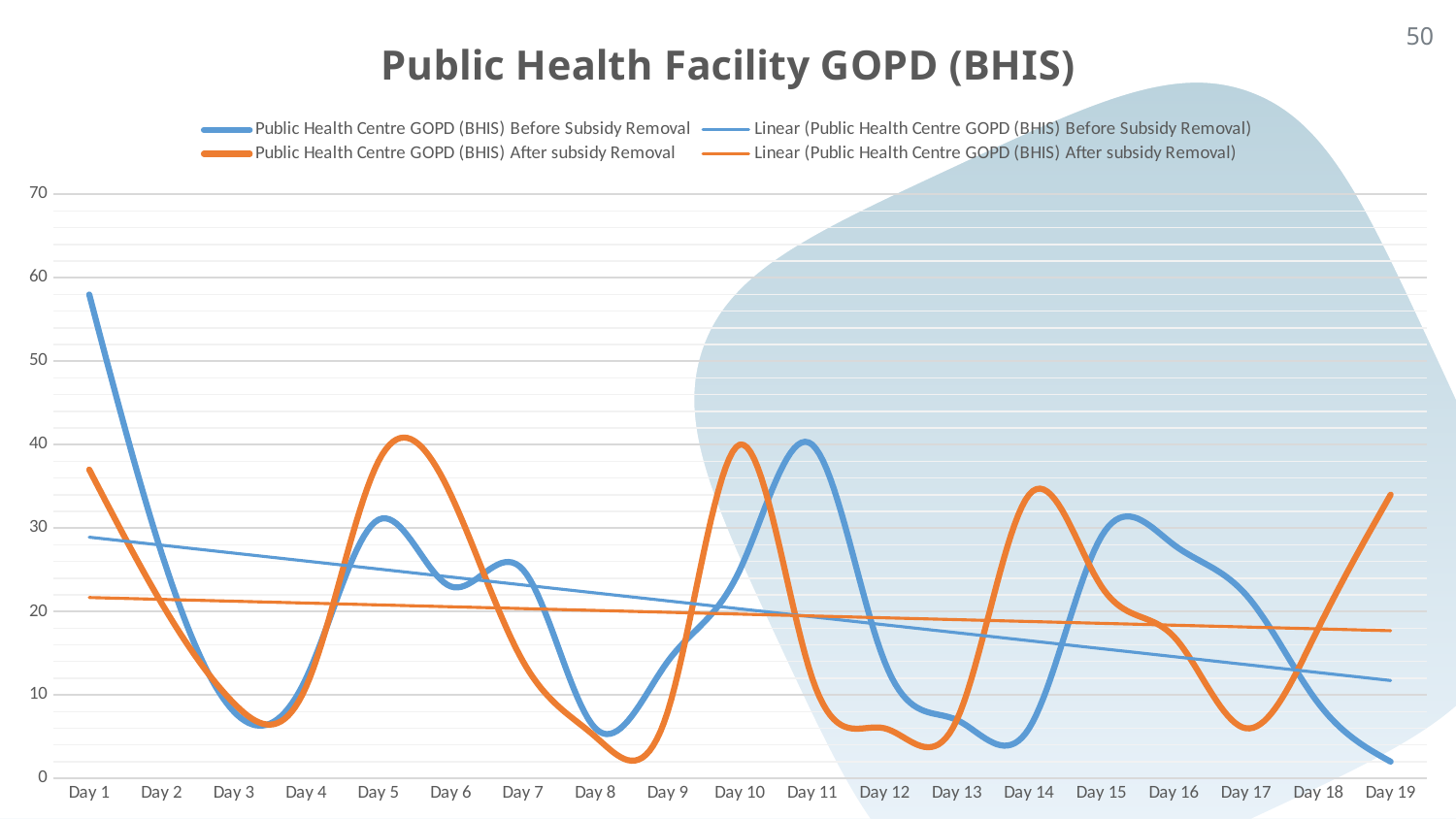
What colour is the line for the After subsidy Removal series? orange Is the value for Day 14 in the After subsidy Removal series greater or less than 30? greater How many days are shown along the x axis? 19 Do the linear trendlines rise or fall from Day 1 to Day 19? fall Is the value for Day 19 in the Before Subsidy Removal series greater or less than 10? less Is the value for Day 8 in the Before Subsidy Removal series greater or less than 10? less How many entries does the legend list? 4 On Day 11, which series has the larger value: Before Subsidy Removal or After subsidy Removal? Before Subsidy Removal On which day is the Before Subsidy Removal series highest? Day 1 What kind of chart is shown on the slide? line chart